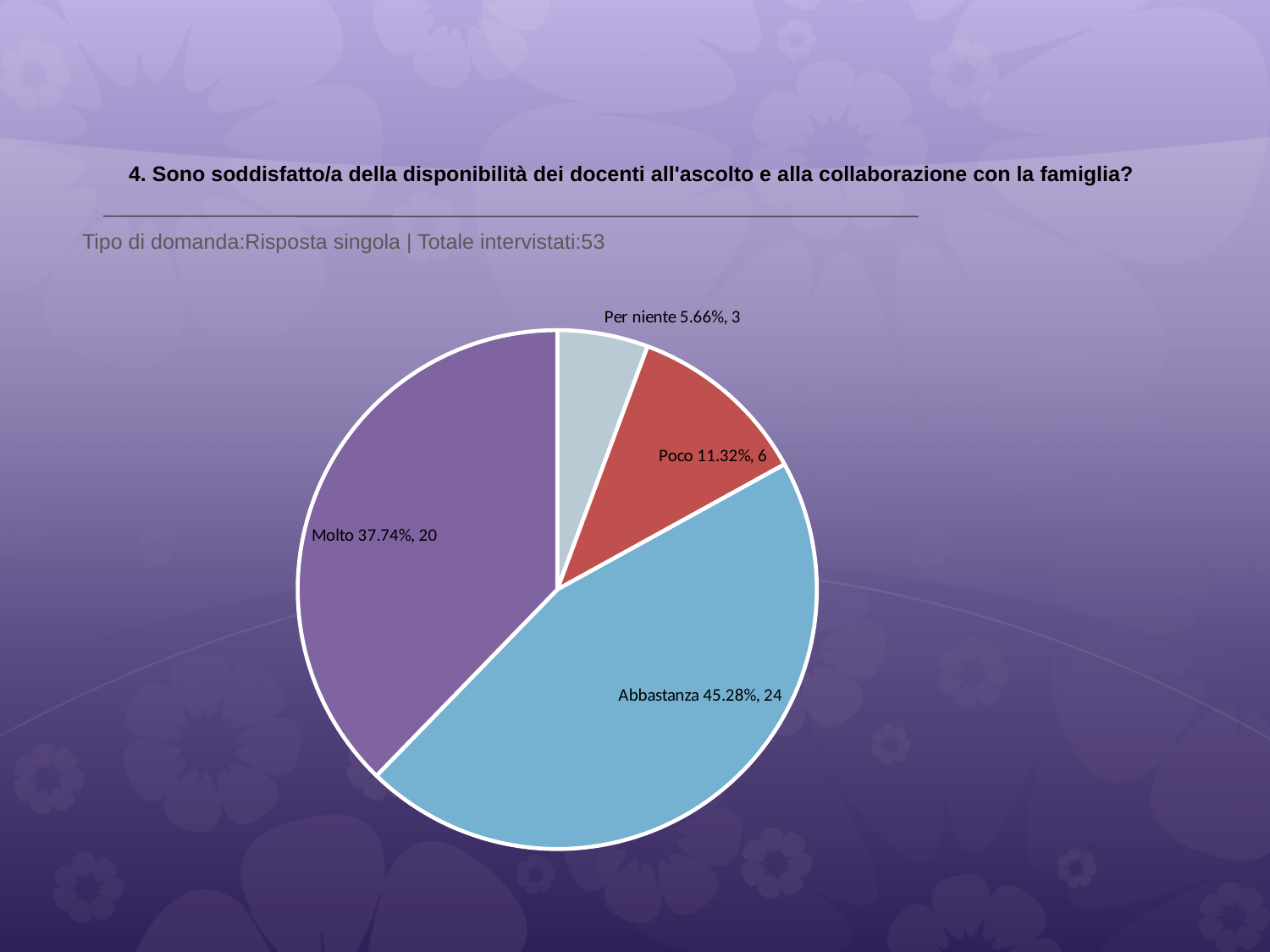
What kind of chart is shown on the slide? pie chart What percentage share does the 'Poco' slice have? 11.32% Which category has the smallest slice? Per niente How many slices does the pie chart have? 4 What percentage share does the 'Abbastanza' slice have? 45.28% Which has more respondents, 'Poco' or 'Per niente'? Poco What colour is the 'Abbastanza' slice? blue How many respondents answered 'Per niente'? 3 What is the difference in respondent count between 'Abbastanza' and 'Molto'? 4 How many respondents answered 'Molto'? 20 What is the total number of respondents shown across all slices? 53 Which category has the largest slice? Abbastanza